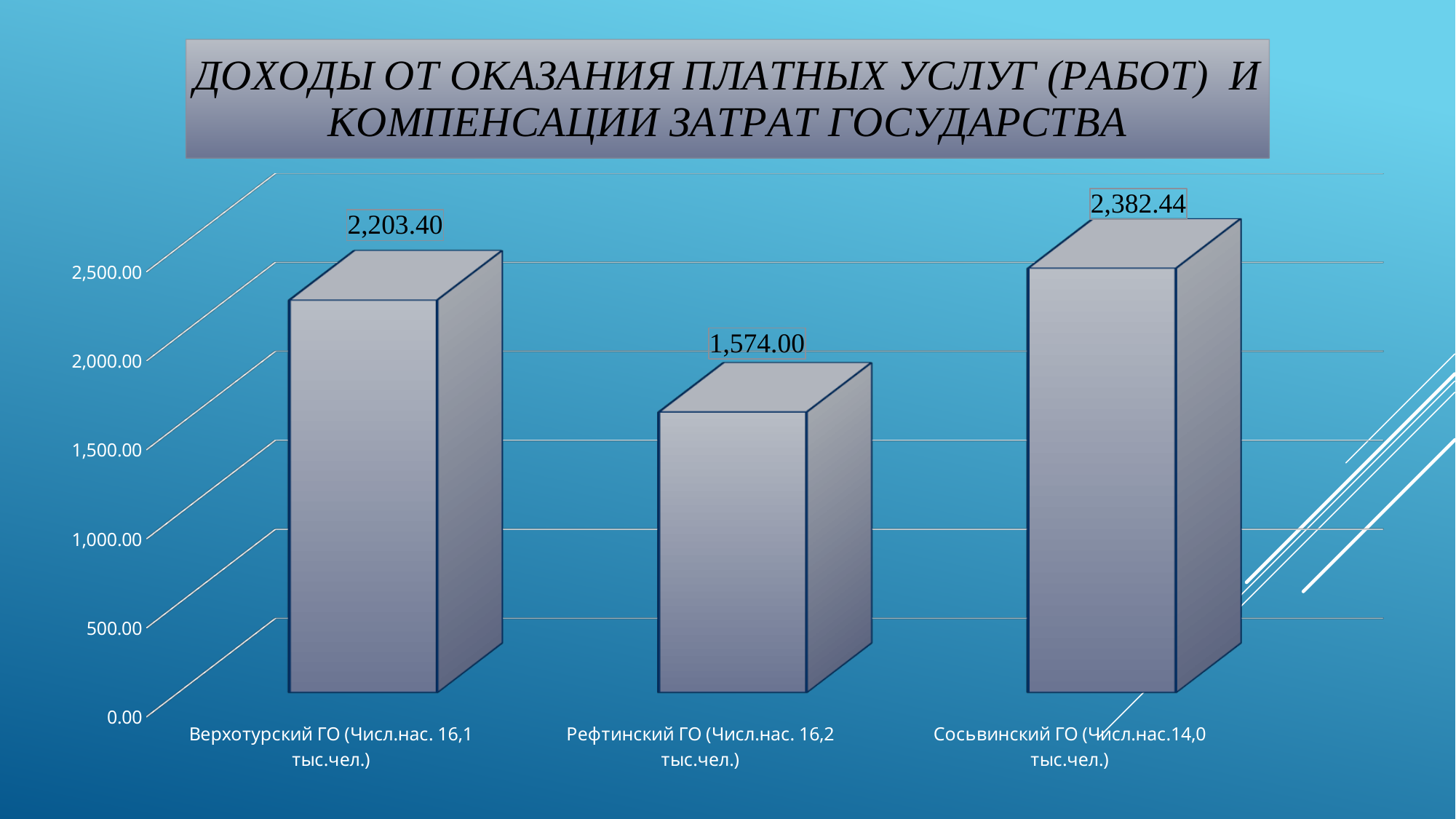
What is the value for Рефтинский ГО? 1,574.00 What is the difference between the values for Сосьвинский ГО and Верхотурский ГО? 179.04 Which category has the lowest value? Рефтинский ГО Which category has the highest value? Сосьвинский ГО What is the title of the slide? ДОХОДЫ ОТ ОКАЗАНИЯ ПЛАТНЫХ УСЛУГ (РАБОТ) И КОМПЕНСАЦИИ ЗАТРАТ ГОСУДАРСТВА What is the value for Сосьвинский ГО? 2,382.44 What is the value for Верхотурский ГО? 2,203.40 Which is larger, the value for Верхотурский ГО or the value for Рефтинский ГО? Верхотурский ГО How many categories are shown in the chart? 3 What kind of chart is shown on the slide? bar chart Is the value for Рефтинский ГО greater or less than 2,000.00? less What is the difference between the values for Верхотурский ГО and Рефтинский ГО? 629.40